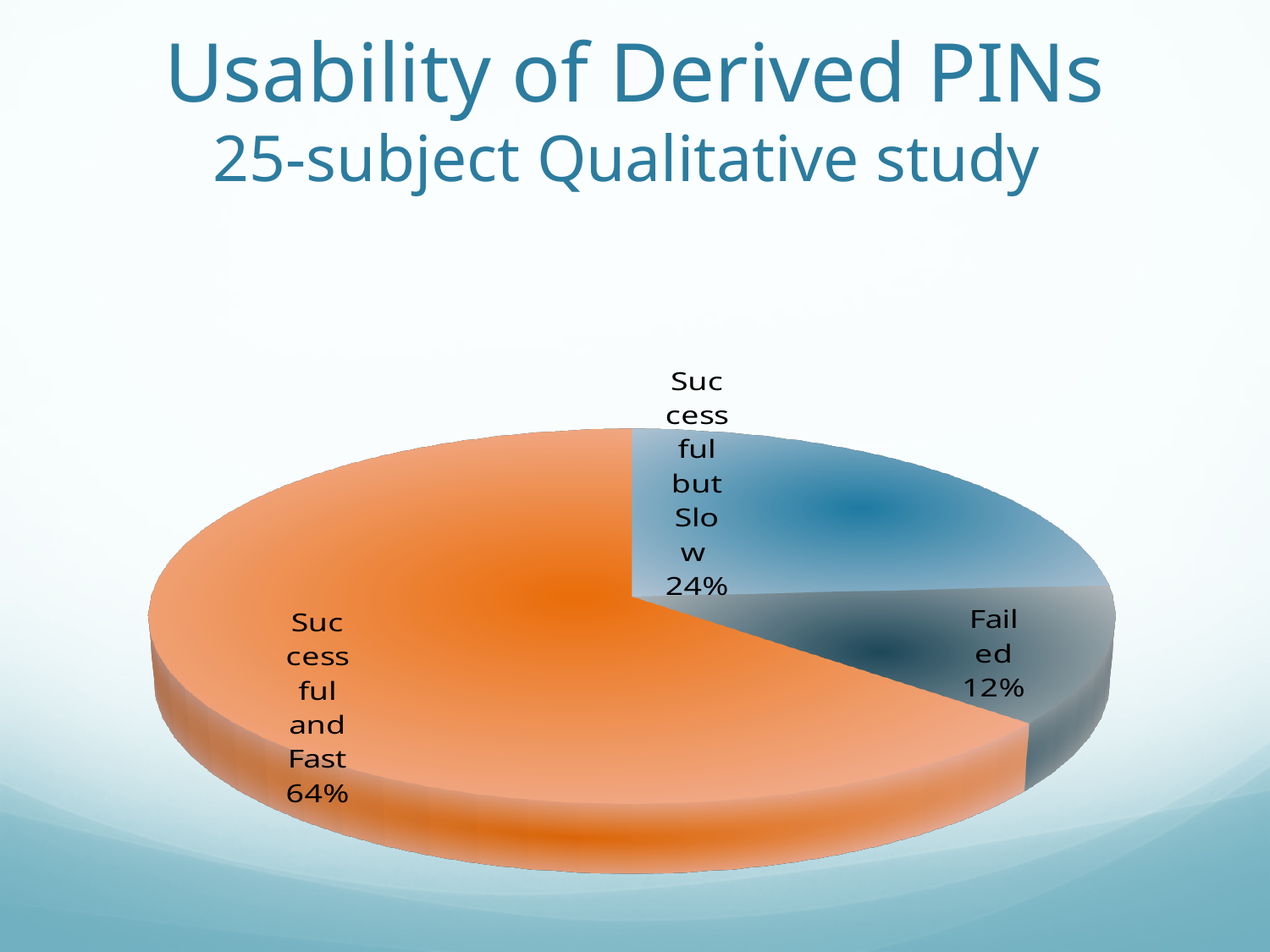
Which slice of the pie is the largest? Successful and Fast What share of the pie is labelled "Successful and Fast"? 64% How many slices does the pie chart have? 3 Which is larger, the "Successful but Slow" slice or the "Failed" slice? Successful but Slow What colour is the "Successful and Fast" slice? orange What share of the pie is labelled "Failed"? 12% What is the title of the slide containing the pie chart? Usability of Derived PINs 25-subject Qualitative study What kind of chart is shown on the slide? pie chart What is the difference in percentage points between the "Successful but Slow" slice and the "Failed" slice? 12 What is the difference in percentage points between the "Successful and Fast" slice and the "Successful but Slow" slice? 40 What share of the pie is labelled "Successful but Slow"? 24% Which slice of the pie is the smallest? Failed